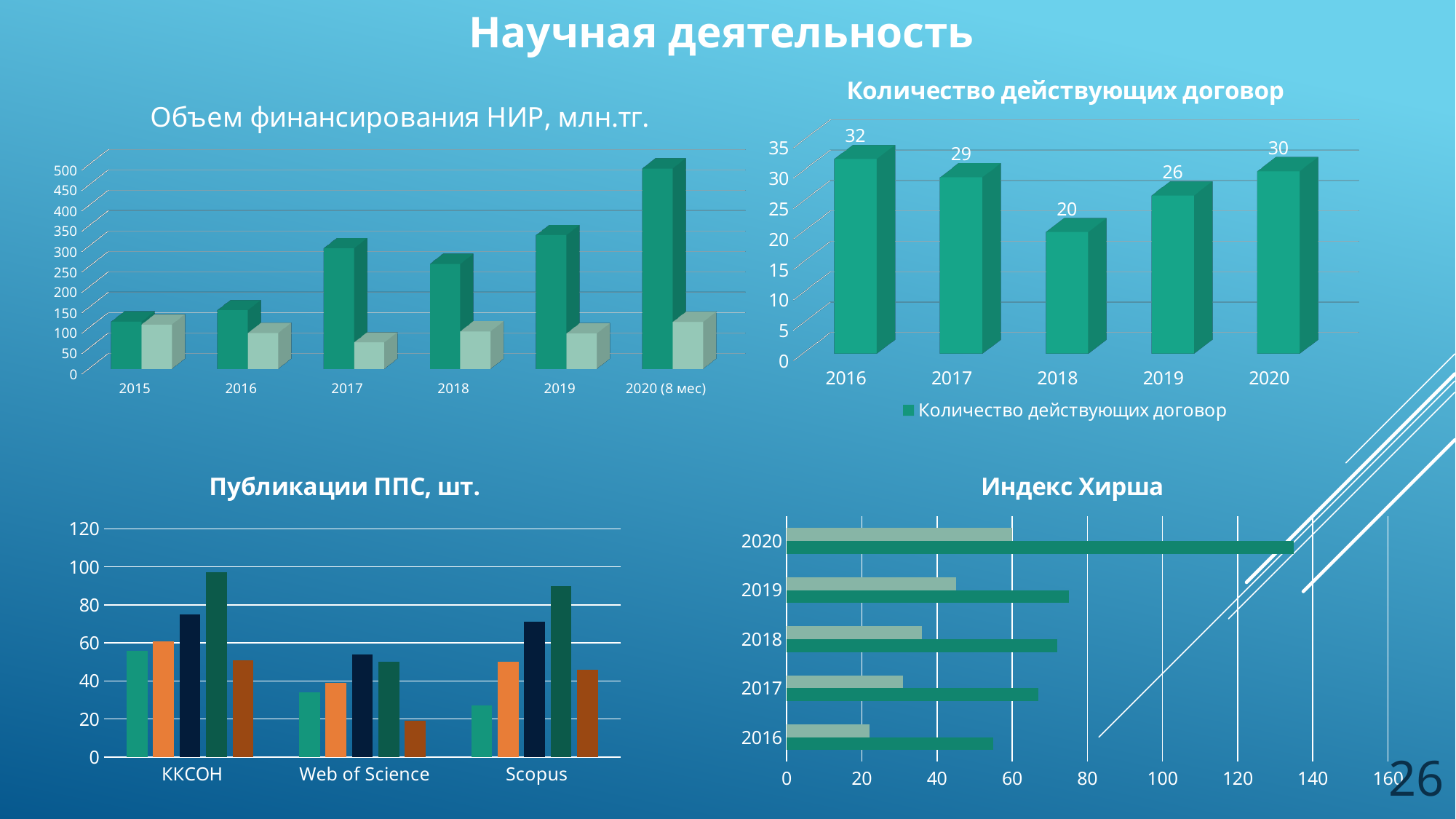
In the chart 'Публикации ППС, шт.', is the tallest bar for ККСОН greater or less than 80? greater What kind of chart is 'Индекс Хирша'? bar chart In the chart 'Количество действующих договор', what is the difference between the values for 2016 and 2018? 12 In the chart 'Количество действующих договор', which year has the highest value? 2016 In the chart 'Количество действующих договор', what is the value for 2018? 20 In the chart 'Индекс Хирша', is the longer (dark green) bar for 2020 greater or less than 120? greater In the chart 'Количество действующих договор', which is larger, the value for 2017 or the value for 2019? 2017 In the chart 'Публикации ППС, шт.', how many categories are shown on the x axis? 3 In the chart 'Объем финансирования НИР, млн.тг.', how many categories are shown on the x axis? 6 In the chart 'Количество действующих договор', what is the value for 2016? 32 In the chart 'Количество действующих договор', which year has the lowest value? 2018 In the chart 'Объем финансирования НИР, млн.тг.', which category has the tallest dark green bar? 2020 (8 мес)